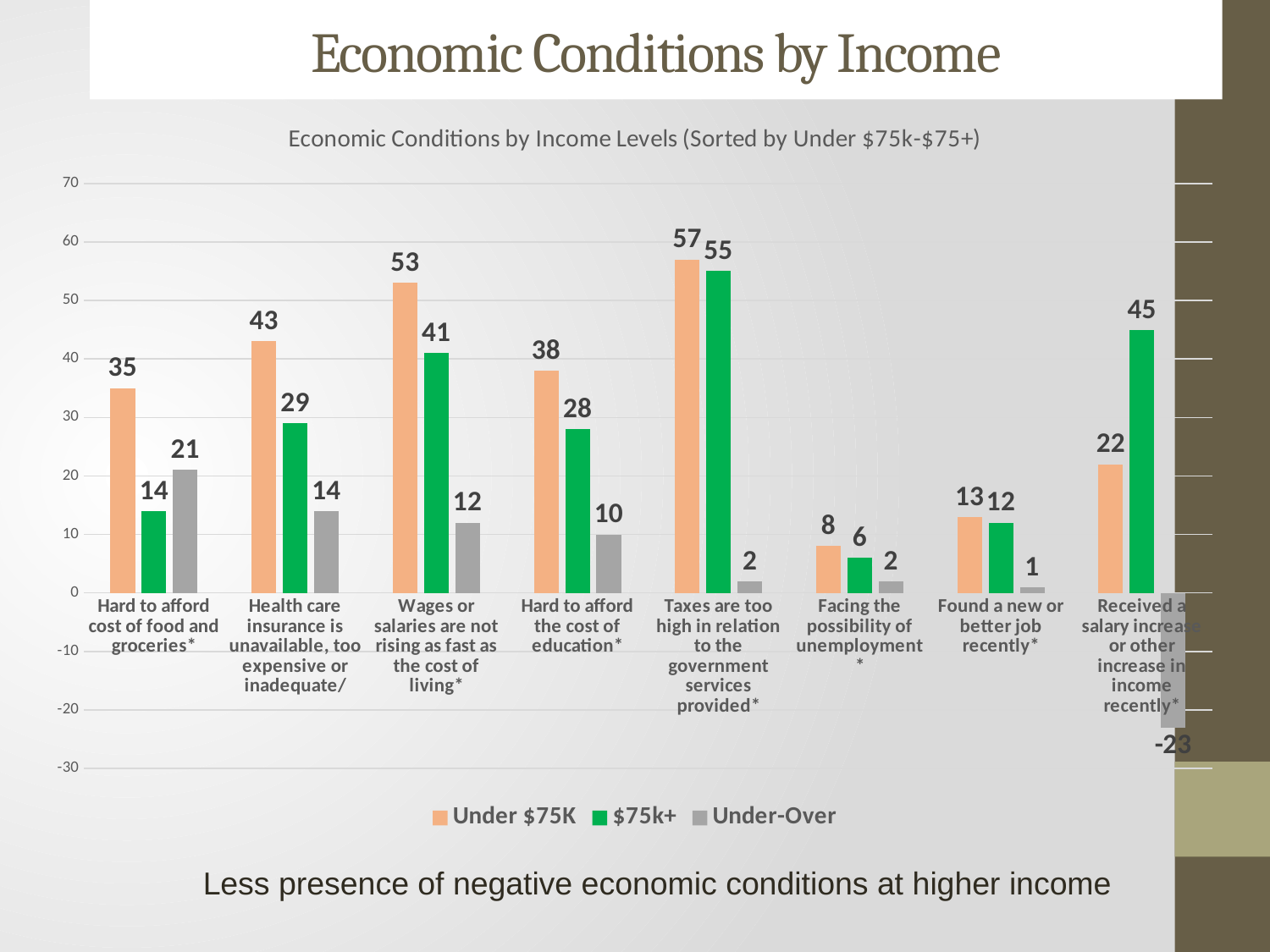
What kind of chart is shown on the slide? Bar chart How many categories are shown on the x axis? 8 What is the value for Under $75K for "Hard to afford cost of food and groceries"? 35 Which category has the highest Under $75K value? Taxes are too high in relation to the government services provided For "Received a salary increase or other increase in income recently", which is larger: the Under $75K value or the $75k+ value? $75k+ What is the $75k+ value for "Hard to afford the cost of education"? 28 How many series does the legend list? 3 What is the value for $75k+ for "Wages or salaries are not rising as fast as the cost of living"? 41 What is the difference between the Under $75K and $75k+ values for "Health care insurance is unavailable, too expensive or inadequate"? 14 What is the Under-Over value for "Received a salary increase or other increase in income recently"? -23 Which category has the lowest $75k+ value? Facing the possibility of unemployment What is the title of the chart? Economic Conditions by Income Levels (Sorted by Under $75k-$75+)